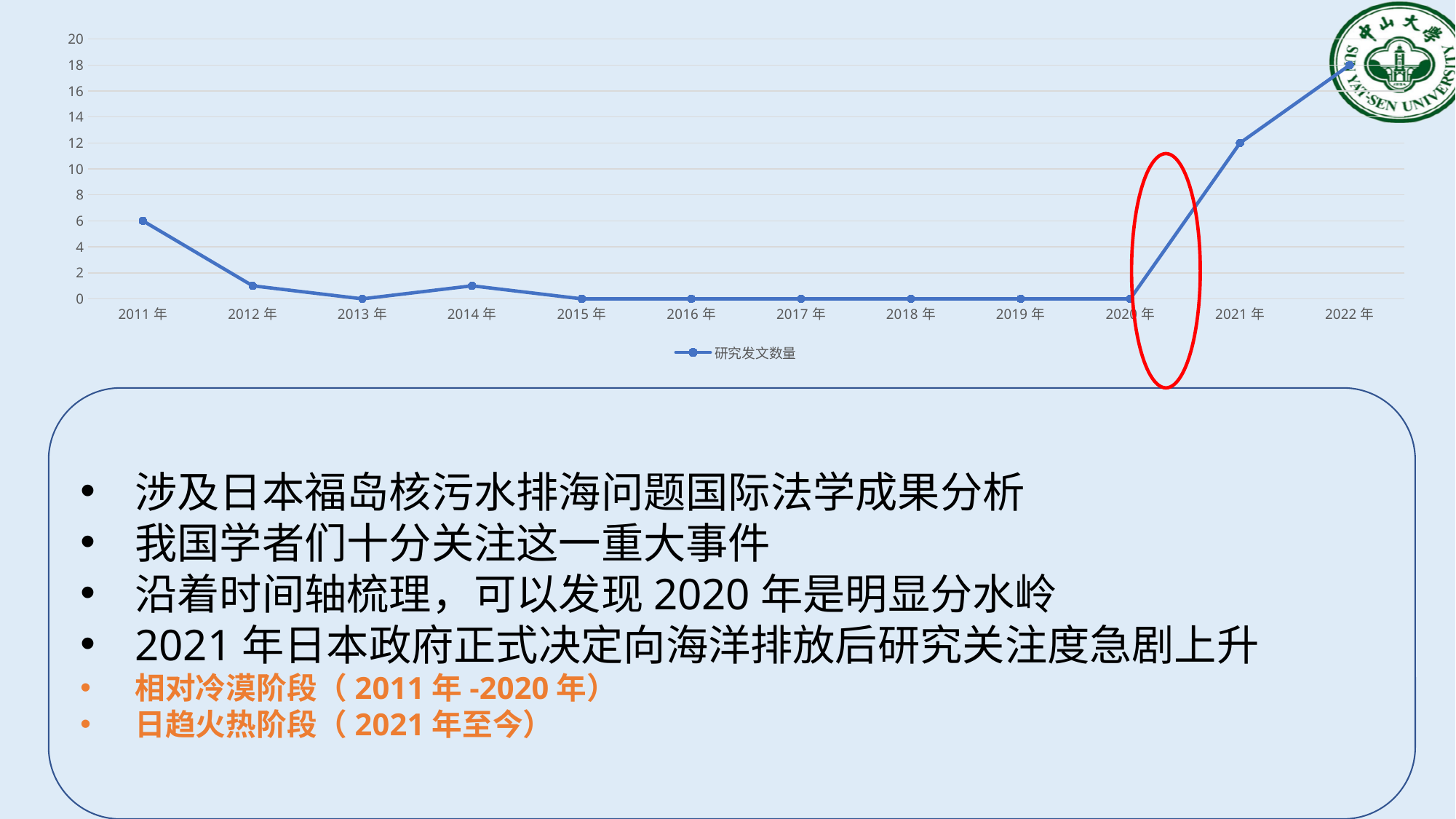
What is the value for 2021 年? 12 Is the value for 2012 年 greater or less than 2? less What is the difference between the values for 2022 年 and 2021 年? 6 What is the value for 2020 年? 0 Which year has the highest value? 2022 年 What is the name of the series shown in the legend? 研究发文数量 What is the value for 2022 年? 18 How many years are shown on the x axis? 12 Which is larger, the value for 2011 年 or the value for 2021 年? 2021 年 What kind of chart is shown on the slide? line chart How many series does the legend list? 1 What is the value for 2011 年? 6